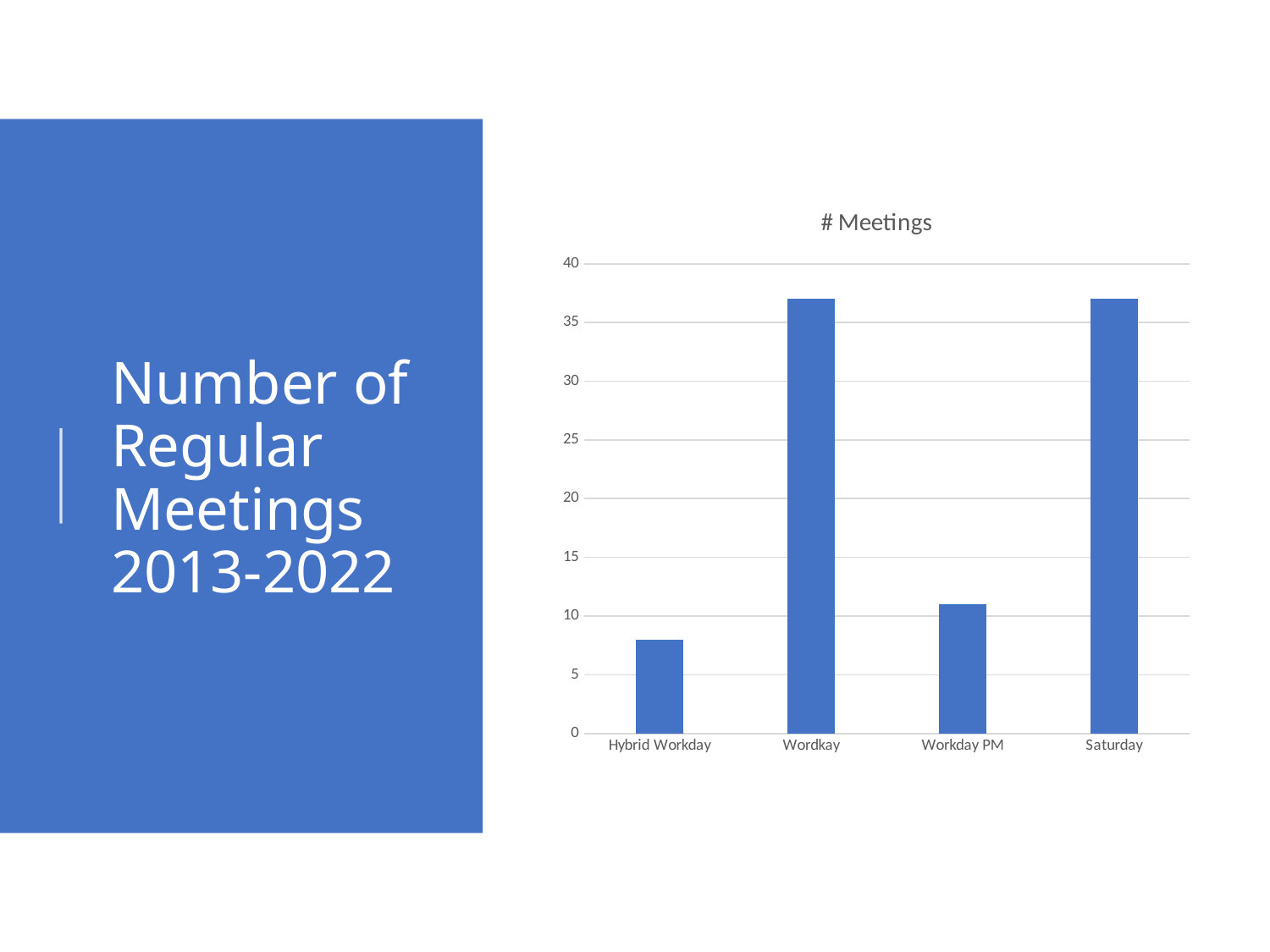
Is the value for Workday PM greater or less than 10? greater What kind of chart is shown on the slide? bar chart Which category has the lowest number of meetings? Hybrid Workday Is the value for Hybrid Workday greater or less than 10? less Which is larger, the value for Hybrid Workday or the value for Workday PM? Workday PM How many categories are shown on the x axis of the chart? 4 What is the title of the chart? # Meetings Is the value for Saturday greater or less than 30? greater What is the highest value shown on the y axis of the chart? 40 Which is larger, the value for Wordkay or the value for Workday PM? Wordkay